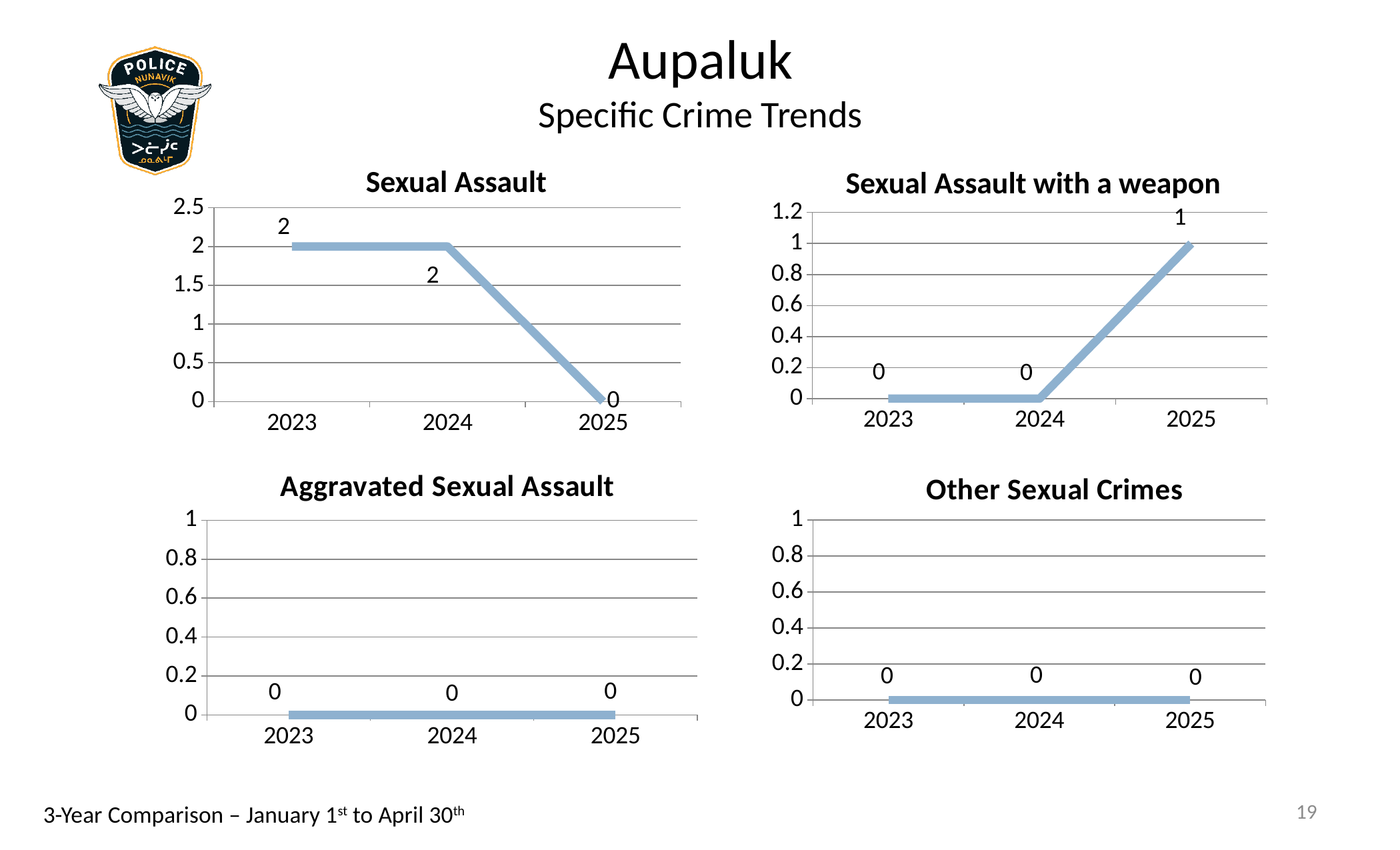
In the Other Sexual Crimes chart, what is the value for 2023? 0 In the Sexual Assault with a weapon chart, which year has the highest value? 2025 What kind of chart is the Sexual Assault chart? line chart In the Sexual Assault chart, what is the value for 2025? 0 How many years are plotted in the Other Sexual Crimes chart? 3 In the Sexual Assault with a weapon chart, what is the value for 2025? 1 In the Aggravated Sexual Assault chart, what is the value for 2024? 0 In the Sexual Assault chart, what is the value for 2023? 2 In the Sexual Assault with a weapon chart, is the value for 2025 larger than the value for 2024? Yes In the Sexual Assault chart, do the values rise or fall from 2024 to 2025? fall How many charts are shown on the slide? 4 In the Sexual Assault chart, what is the difference between the 2024 and 2025 values? 2